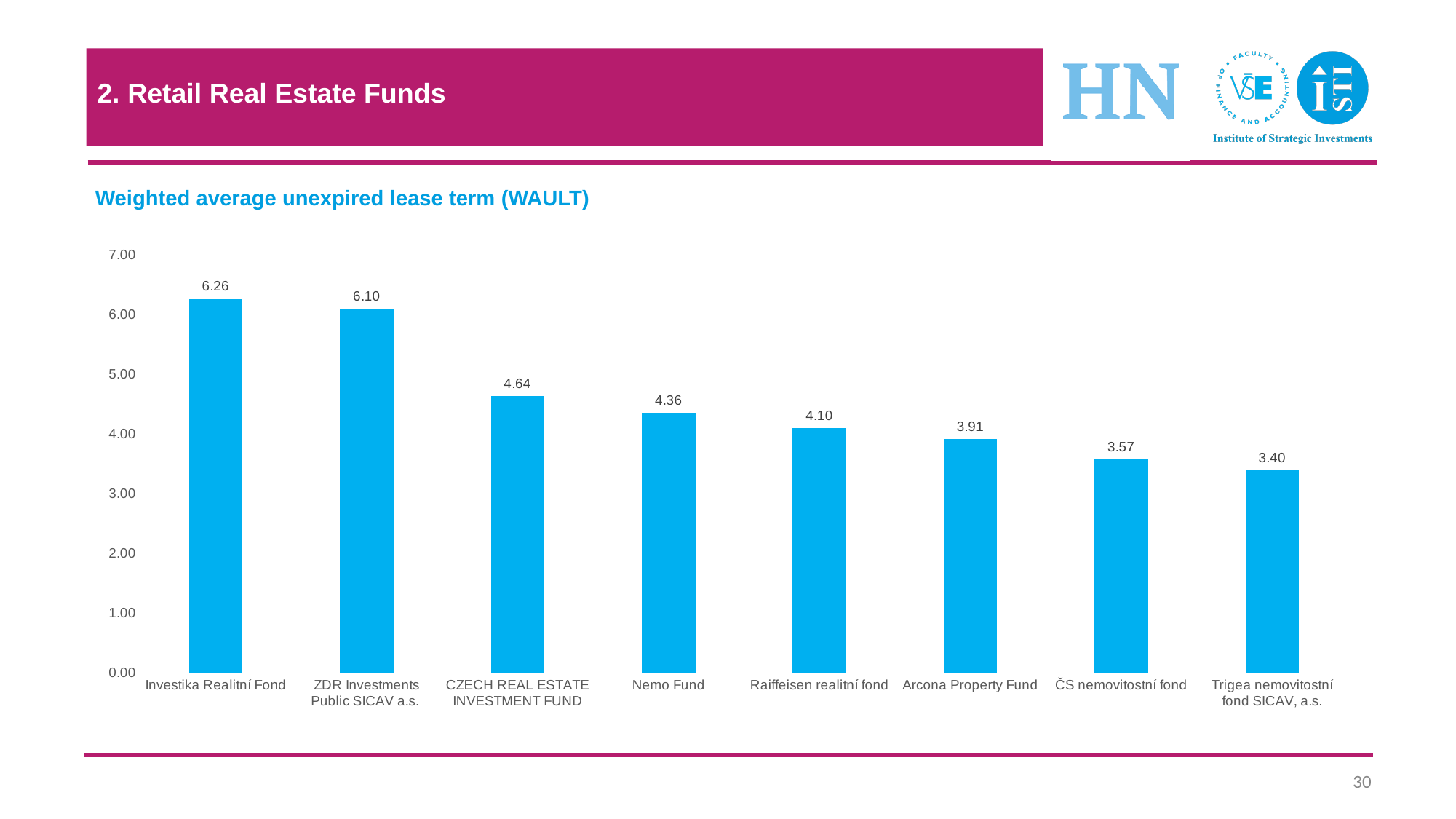
What is the WAULT value for Arcona Property Fund? 3.91 Which fund has the lowest WAULT? Trigea nemovitostní fond SICAV, a.s. What kind of chart is shown on the slide? Bar chart Do the WAULT values rise or fall from left to right across the chart? Fall What is the difference between the WAULT of Investika Realitní Fond and ZDR Investments Public SICAV a.s.? 0.16 What is the difference between the WAULT of CZECH REAL ESTATE INVESTMENT FUND and ČS nemovitostní fond? 1.07 Which has a higher WAULT, Raiffeisen realitní fond or Arcona Property Fund? Raiffeisen realitní fond What is the WAULT value for Investika Realitní Fond? 6.26 What is the WAULT value for Nemo Fund? 4.36 How many funds are shown in the chart? 8 Is the WAULT value for ZDR Investments Public SICAV a.s. greater or less than 5.00? greater Which fund has the highest WAULT? Investika Realitní Fond